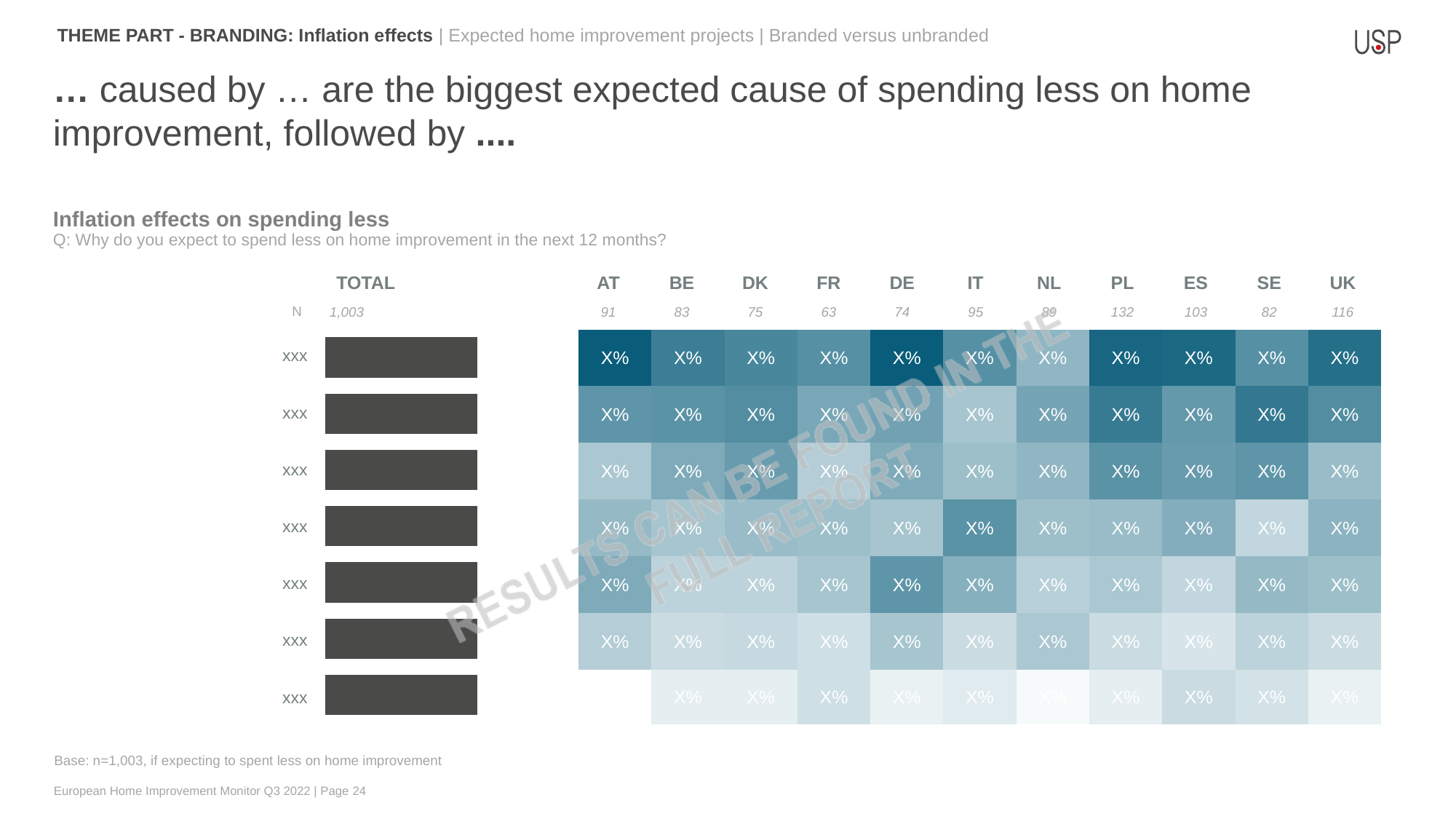
Which has a larger N, UK or ES? UK What is the N (sample size) shown for the TOTAL column? 1,003 What kind of chart is shown on the left side of the slide under the TOTAL column? bar chart Which country column has the lowest N (sample size)? FR Which country column has the highest N (sample size)? PL How many country columns are shown in the heatmap to the right of the bar chart? 11 What is the N (sample size) shown for PL? 132 What is the N (sample size) shown for FR? 63 What is the title of the chart on the slide? Inflation effects on spending less How many bars are shown in the TOTAL bar chart? 7 What is the N (sample size) shown for IT? 95 What is the difference between the N for PL and the N for FR? 69